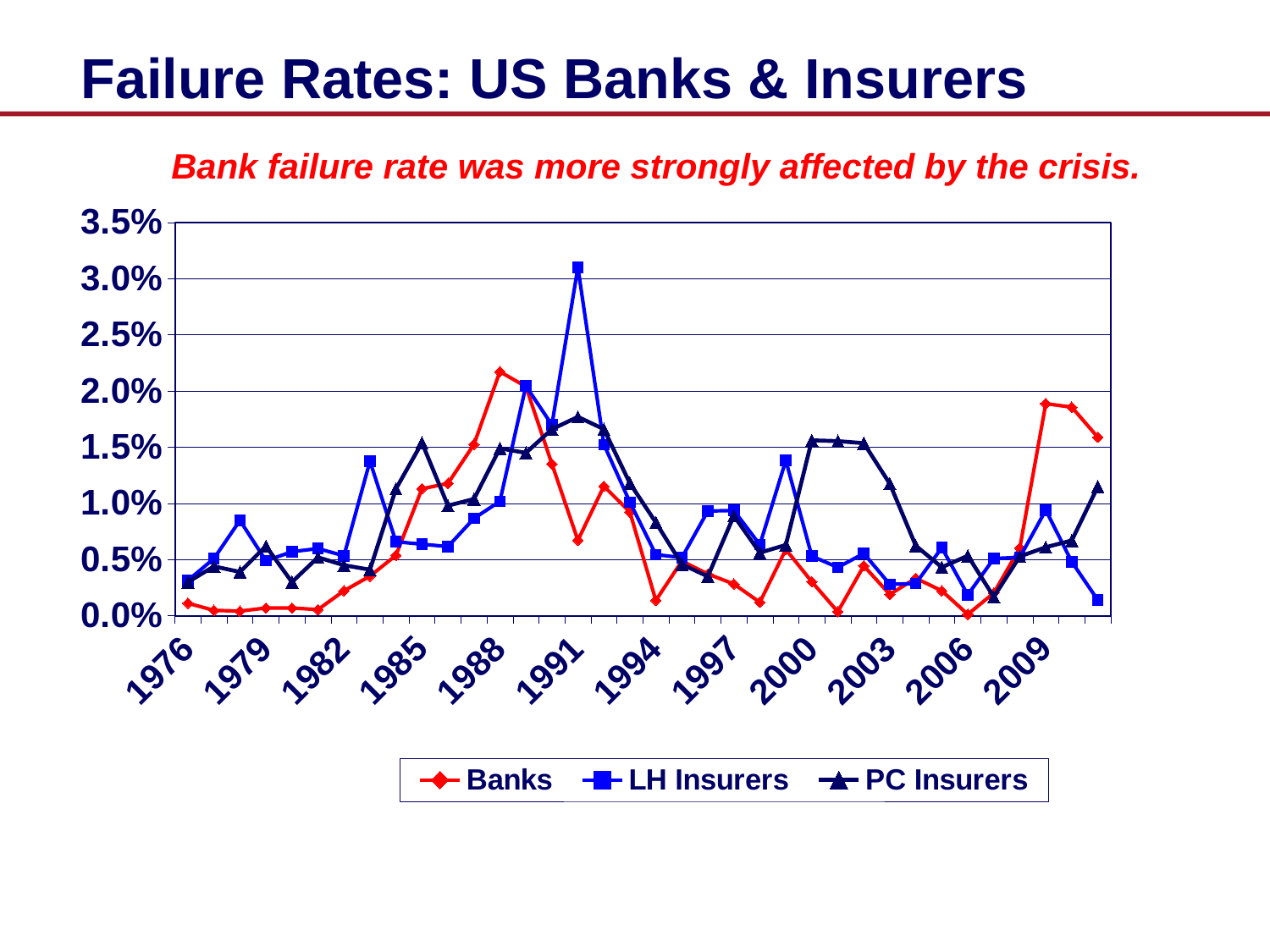
What colour is the Banks line? red In 2009, which is higher, Banks or LH Insurers? Banks Does the Banks line rise or fall between 2006 and 2009? rise What is the subtitle shown above the chart? Bank failure rate was more strongly affected by the crisis. What kind of chart is shown on the slide? line chart Is the value for Banks in 1976 greater or less than 0.5%? less Is the value for PC Insurers in 2000 greater or less than 1.0%? greater Is the value for Banks in 2009 greater or less than 1.5%? greater How many series does the legend list? 3 Which series reaches the highest failure rate at any point on the chart? LH Insurers In 1991, which is higher, LH Insurers or Banks? LH Insurers